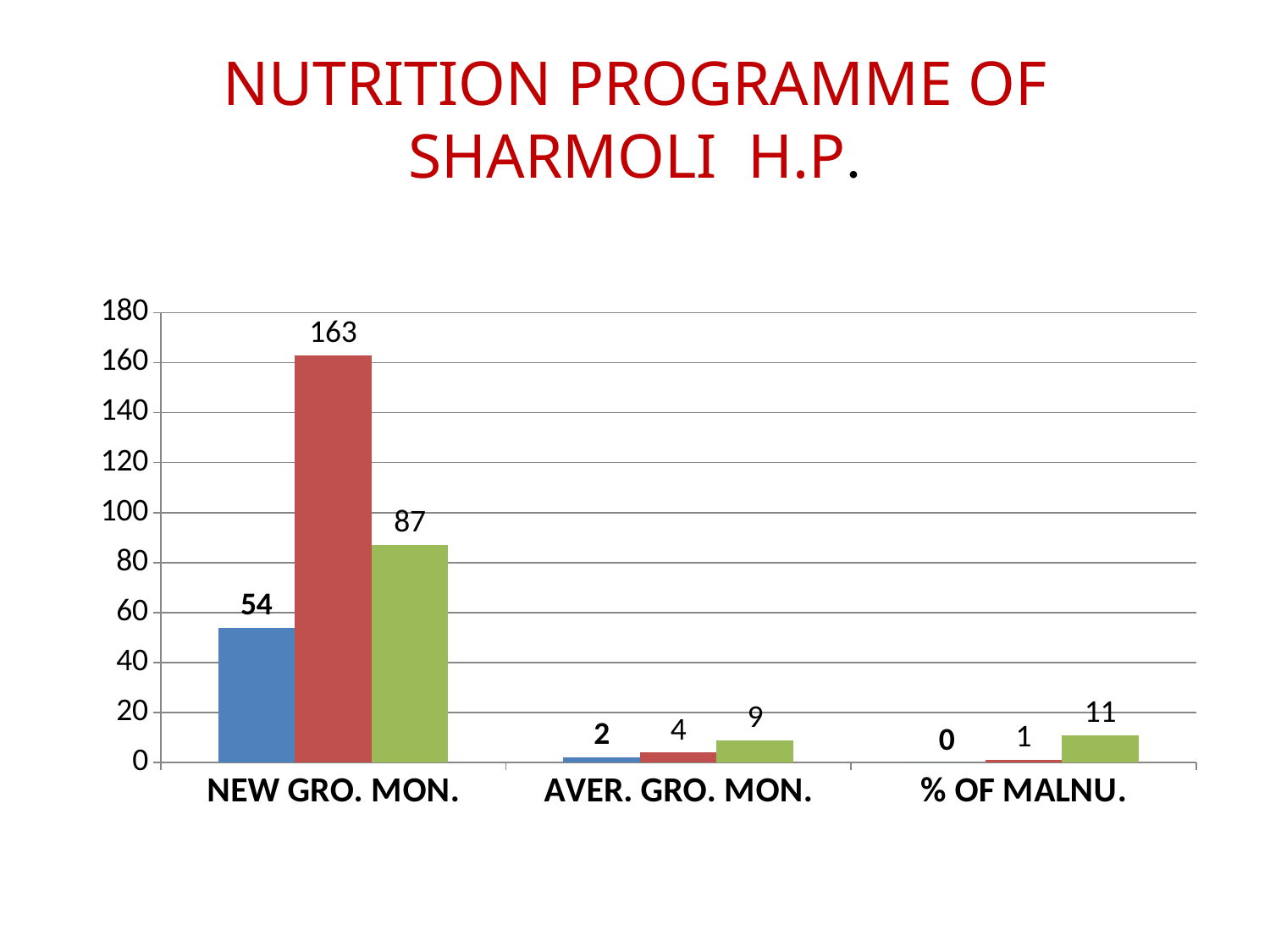
Which category has the lowest value for the blue bars? % OF MALNU. Is the value of the red bar for NEW GRO. MON. greater or less than 140? greater What is the value of the red bar for NEW GRO. MON.? 163 What is the value of the blue bar for NEW GRO. MON.? 54 Which category has the highest value for the red bars? NEW GRO. MON. What is the title of the slide containing the chart? NUTRITION PROGRAMME OF SHARMOLI H.P. How many categories are shown on the x axis? 3 What kind of chart is shown on the slide? bar chart Which is larger for AVER. GRO. MON., the blue bar or the red bar? the red bar What is the difference between the red bar and the green bar for NEW GRO. MON.? 76 What is the value of the green bar for AVER. GRO. MON.? 9 What is the value of the green bar for % OF MALNU.? 11